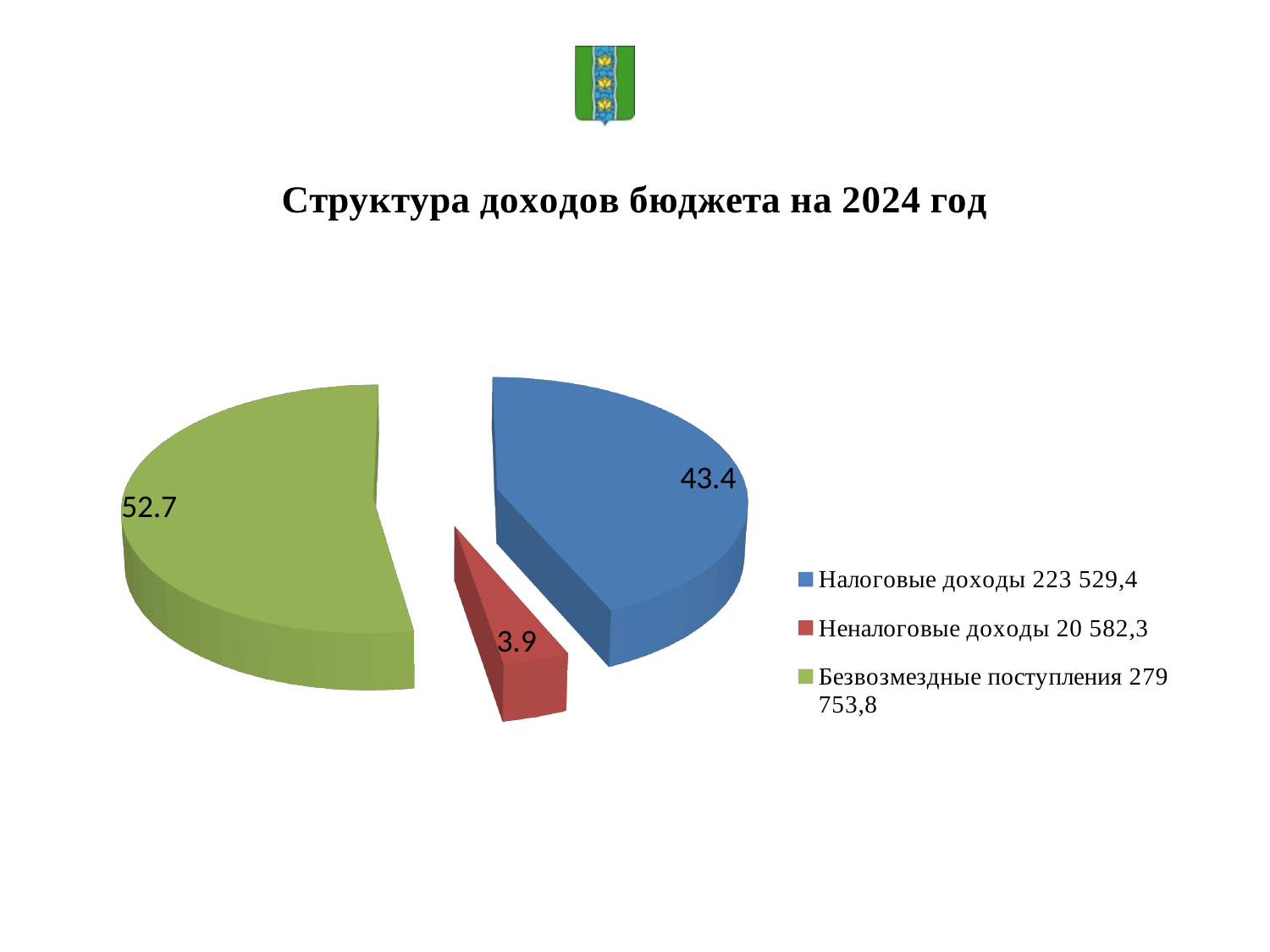
What is the difference between the values shown for Налоговые доходы and Неналоговые доходы? 39.5 What kind of chart is shown on the slide? Pie chart What value is shown on the Безвозмездные поступления slice of the pie chart? 52.7 Which category has the largest slice of the pie chart? Безвозмездные поступления Which is larger, the slice for Налоговые доходы or the slice for Безвозмездные поступления? Безвозмездные поступления Which category has the smallest slice of the pie chart? Неналоговые доходы What is the title of the chart on the slide? Структура доходов бюджета на 2024 год What value is shown on the Неналоговые доходы slice of the pie chart? 3.9 What amount is listed in the legend for Налоговые доходы? 223 529,4 What is the difference between the values shown for Безвозмездные поступления and Налоговые доходы? 9.3 How many slices does the pie chart have? 3 What value is shown on the Налоговые доходы slice of the pie chart? 43.4